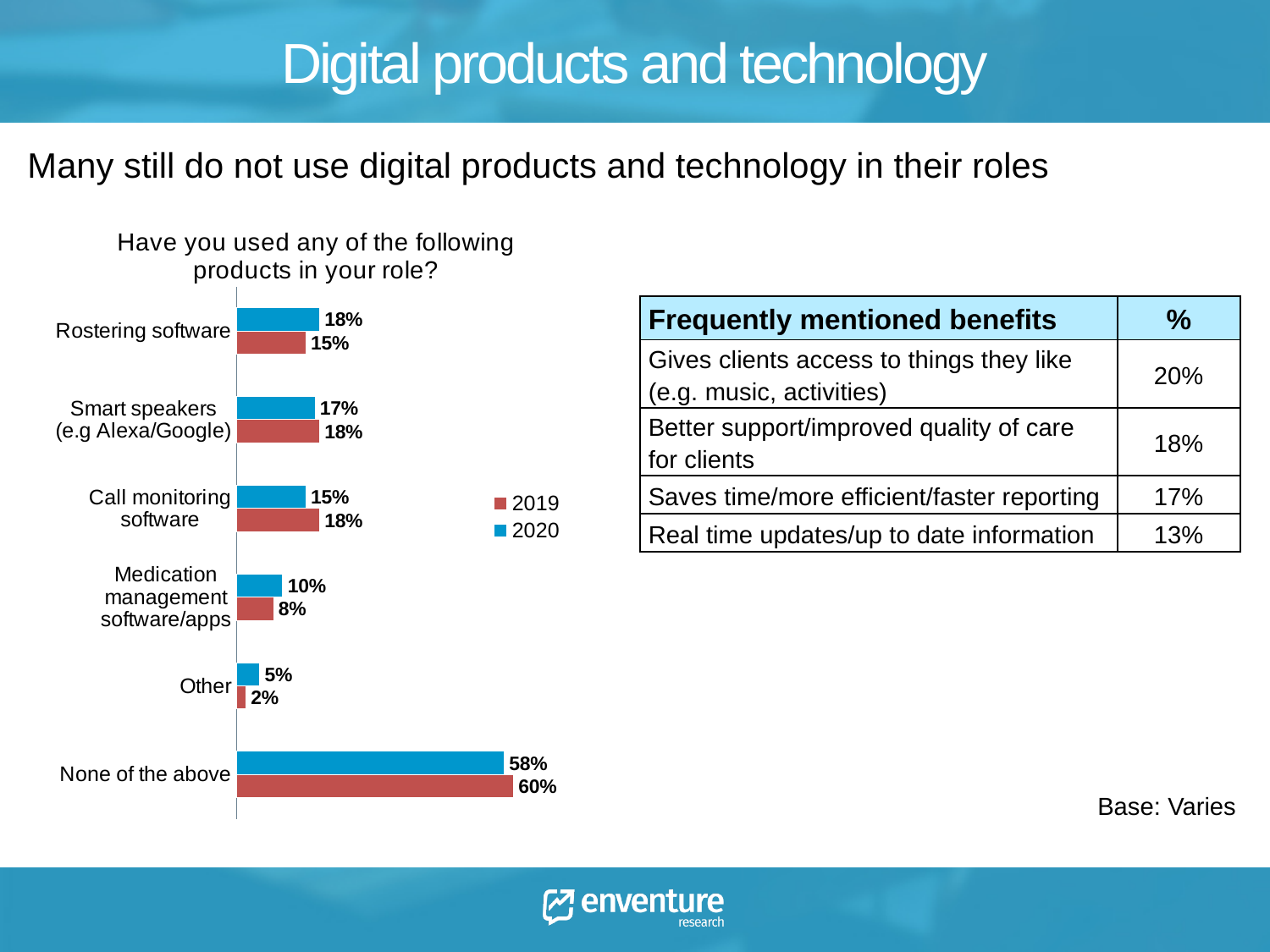
What is the 2019 value for Other? 2% Which category has the lowest 2019 value? Other How many series does the legend list? 2 Which colour represents the 2019 series in the chart? Red What kind of chart is shown on the slide? Bar chart Which category has the highest 2020 value? None of the above How many categories are shown in the chart? 6 What is the 2019 value for Smart speakers (e.g Alexa/Google)? 18% What is the difference between the 2019 and 2020 values for Call monitoring software? 3% What is the title of the chart? Have you used any of the following products in your role? What is the 2020 value for Rostering software? 18% Which is larger for Medication management software/apps, the 2019 value or the 2020 value? 2020